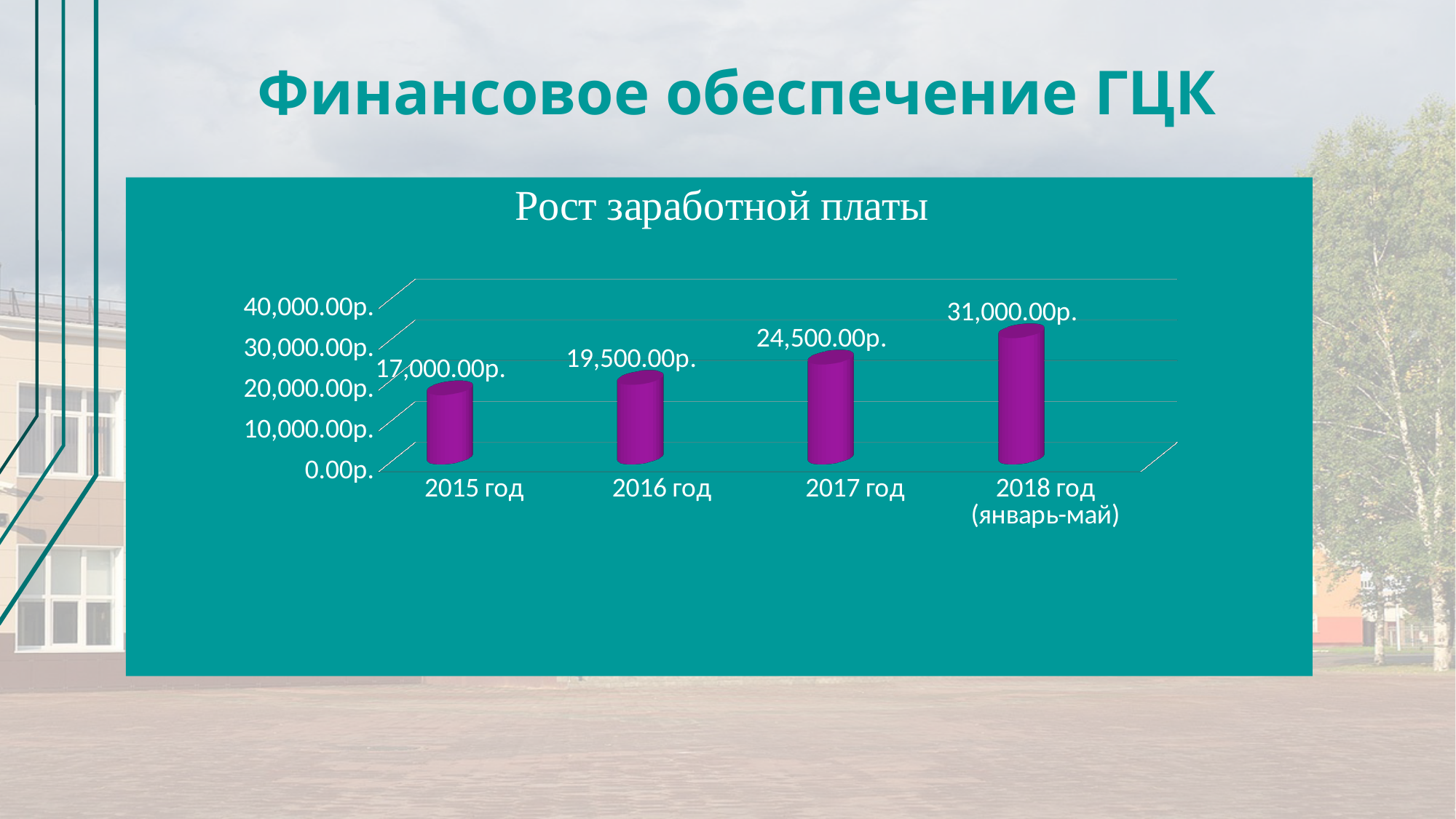
What is the difference between the values for 2017 год and 2016 год? 5,000.00р. Which category has the highest value? 2018 год (январь-май) How many categories are shown on the x axis? 4 Is the value for 2018 год (январь-май) greater or less than 30,000.00р.? greater Which category has the lowest value? 2015 год What kind of chart is shown? bar chart Do the values rise or fall from 2015 год to 2018 год (январь-май)? rise What is the value for 2015 год? 17,000.00р. What is the value for 2018 год (январь-май)? 31,000.00р. Which is larger, the value for 2016 год or the value for 2017 год? 2017 год What is the difference between the values for 2018 год (январь-май) and 2015 год? 14,000.00р. What is the value for 2017 год? 24,500.00р.